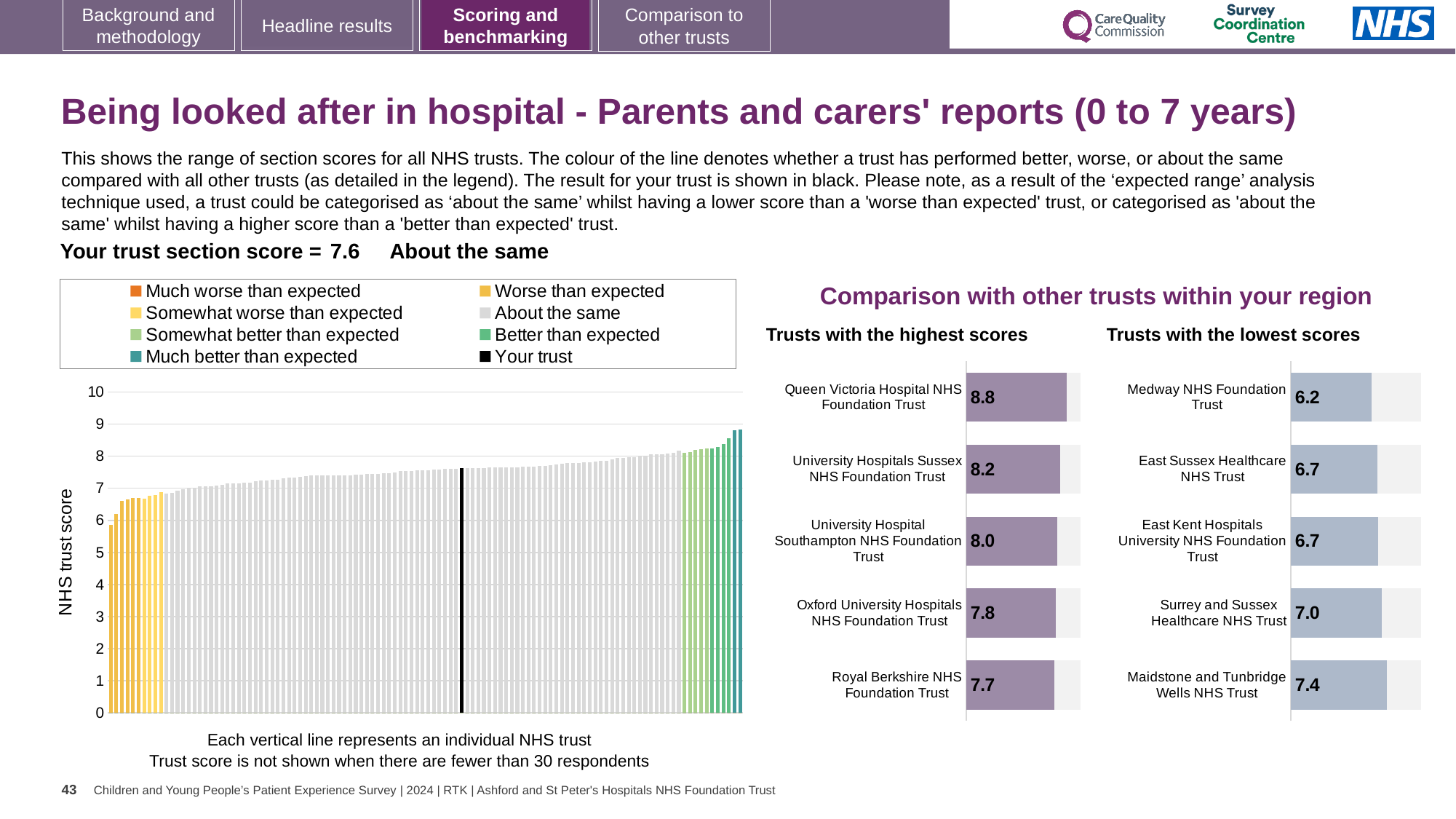
In the main 'NHS trust score' chart, what is the section score for your trust (the black bar)? 7.6 In the 'Trusts with the highest scores' chart, what is the score for Queen Victoria Hospital NHS Foundation Trust? 8.8 In the 'Trusts with the lowest scores' chart, what is the difference between the scores of Maidstone and Tunbridge Wells NHS Trust and Medway NHS Foundation Trust? 1.2 Which has a higher score: University Hospital Southampton NHS Foundation Trust in the highest scores chart, or Surrey and Sussex Healthcare NHS Trust in the lowest scores chart? University Hospital Southampton NHS Foundation Trust In the main 'NHS trust score' chart, do the bar values rise or fall from left to right? rise In the main 'NHS trust score' chart, is the value of the tallest bar greater or less than 8? greater How many trusts are listed in the 'Trusts with the highest scores' chart? 5 How many entries does the legend of the main 'NHS trust score' chart list? 8 In the 'Trusts with the lowest scores' chart, which trust has the highest score shown? Maidstone and Tunbridge Wells NHS Trust In the 'Trusts with the highest scores' chart, what is the difference between the scores of Queen Victoria Hospital NHS Foundation Trust and Oxford University Hospitals NHS Foundation Trust? 1.0 In the 'Trusts with the highest scores' chart, which trust has the lowest score shown? Royal Berkshire NHS Foundation Trust In the 'Trusts with the lowest scores' chart, what is the score for Medway NHS Foundation Trust? 6.2